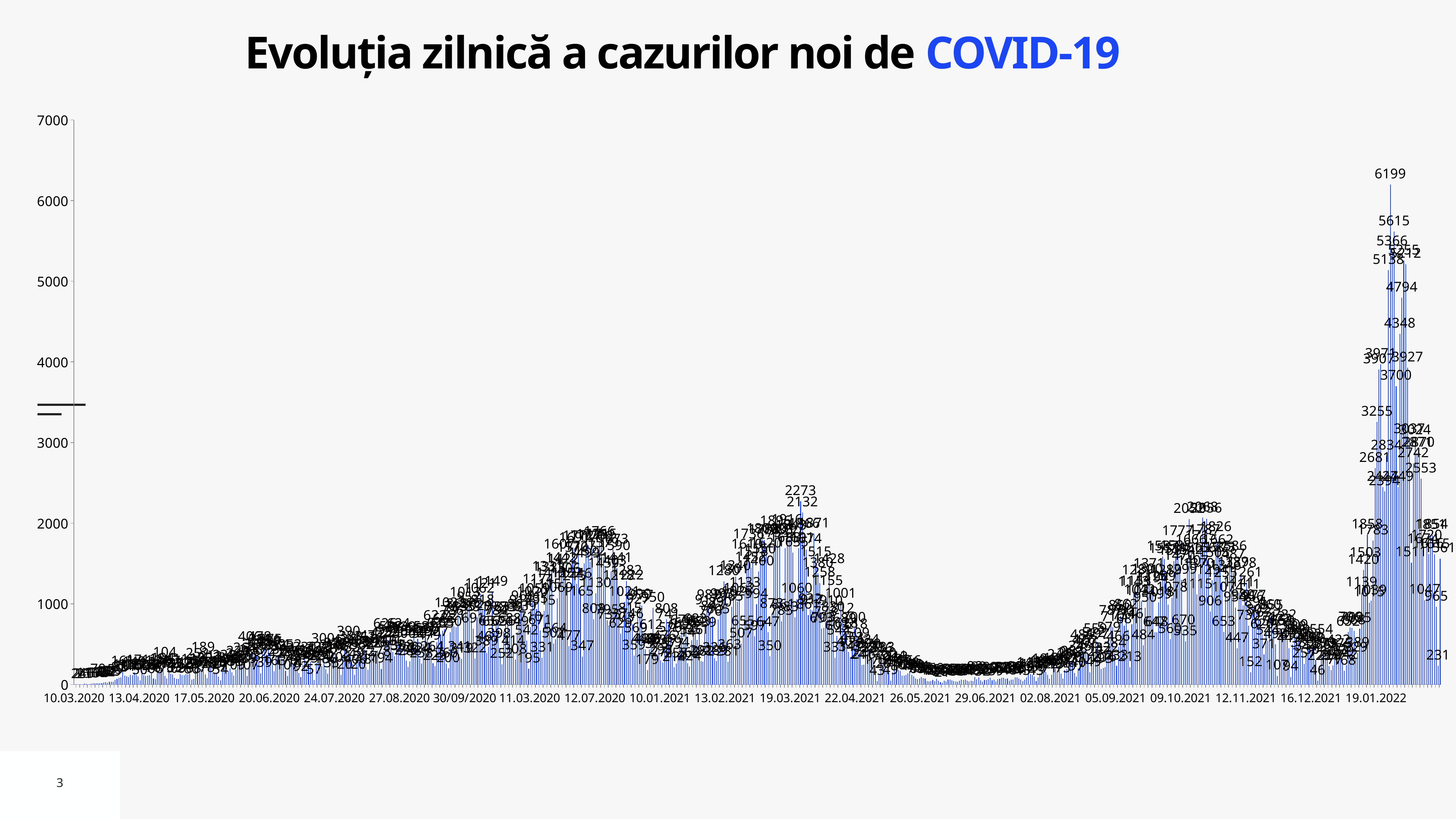
What is the first date label on the horizontal axis? 10.03.2020 Which peak is higher: the one after 19.01.2022 or the one near 19.03.2021? the one after 19.01.2022 What is the last date label on the horizontal axis? 19.01.2022 Do the values rise or fall between 19.03.2021 and 26.05.2021? fall Is the highest value on the chart greater or less than 6000? greater What is the highest daily value labeled on the chart? 6199 Is the peak near 12.07.2020 greater or less than 2000? less What is the highest labeled value in the peak near 19.03.2021? 2273 What kind of chart is shown on the slide? bar chart What is the title of the chart? Evoluția zilnică a cazurilor noi de COVID-19 What is the highest tick value shown on the vertical axis? 7000 What is the difference between the two highest labeled values, 6199 and 5615? 584